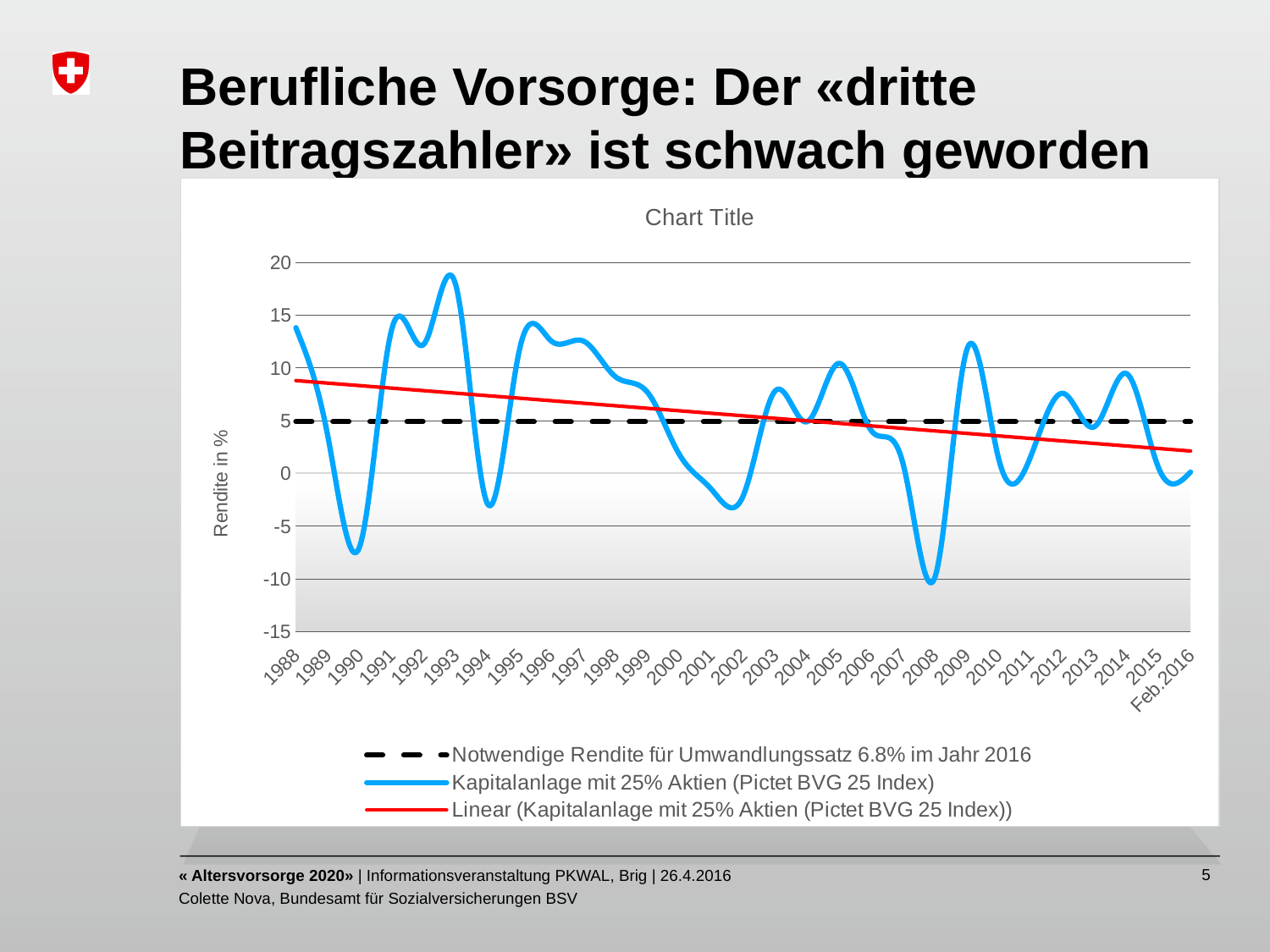
What kind of chart is shown on the slide? line chart Which year has the higher value on the 'Kapitalanlage mit 25% Aktien' line, 1988 or 2000? 1988 In which year does the 'Kapitalanlage mit 25% Aktien (Pictet BVG 25 Index)' line reach its highest value? 1993 Is the value of the 'Kapitalanlage mit 25% Aktien' line for 1988 greater or less than 10? greater How many series does the legend list? 3 What is the title shown above the chart? Chart Title Is the value of the 'Kapitalanlage mit 25% Aktien' line for 1993 greater or less than 15? greater In which year does the 'Kapitalanlage mit 25% Aktien (Pictet BVG 25 Index)' line reach its lowest value? 2008 Is the value of the 'Kapitalanlage mit 25% Aktien' line for 2008 greater or less than -5? less Does the red 'Linear' trend line rise or fall from 1988 to Feb.2016? fall What is the label of the y axis? Rendite in %